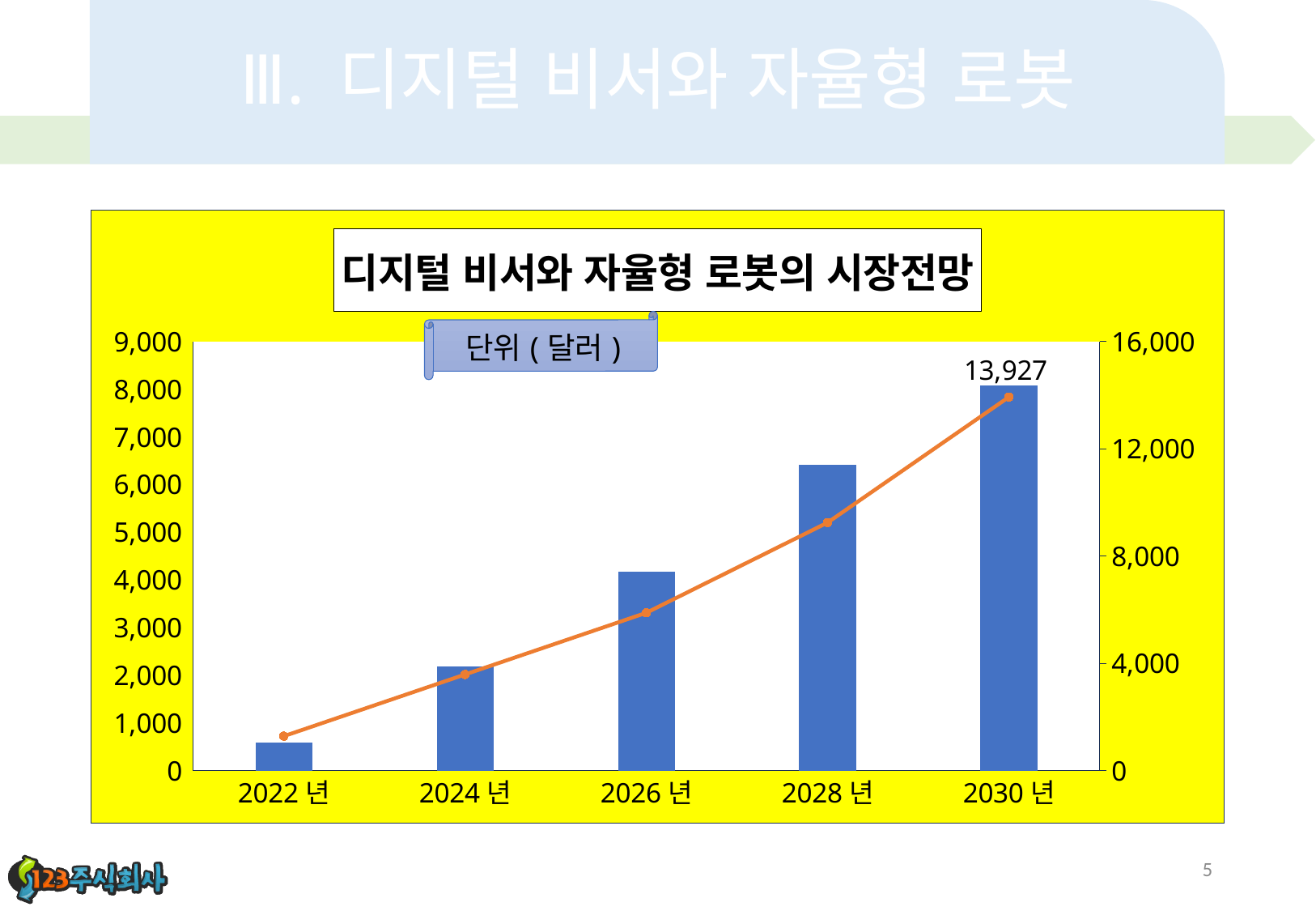
Do the bar values rise or fall from 2022 년 to 2030 년? Rise On the left axis, is the bar for 2028 년 greater or less than 6,000? greater Which year has the shortest bar? 2022 년 On the left axis, is the bar for 2030 년 greater or less than 9,000? less What kind of chart is shown on the slide? Bar chart with a line Which bar is taller, 2024 년 or 2028 년? 2028 년 On the left axis, is the bar for 2022 년 greater or less than 1,000? less What value is printed as a data label at 2030 년? 13,927 What unit does the chart state its values are in? 달러 Which year has the tallest bar? 2030 년 What is the title of the chart? 디지털 비서와 자율형 로봇의 시장전망 How many year categories are shown on the x axis? 5